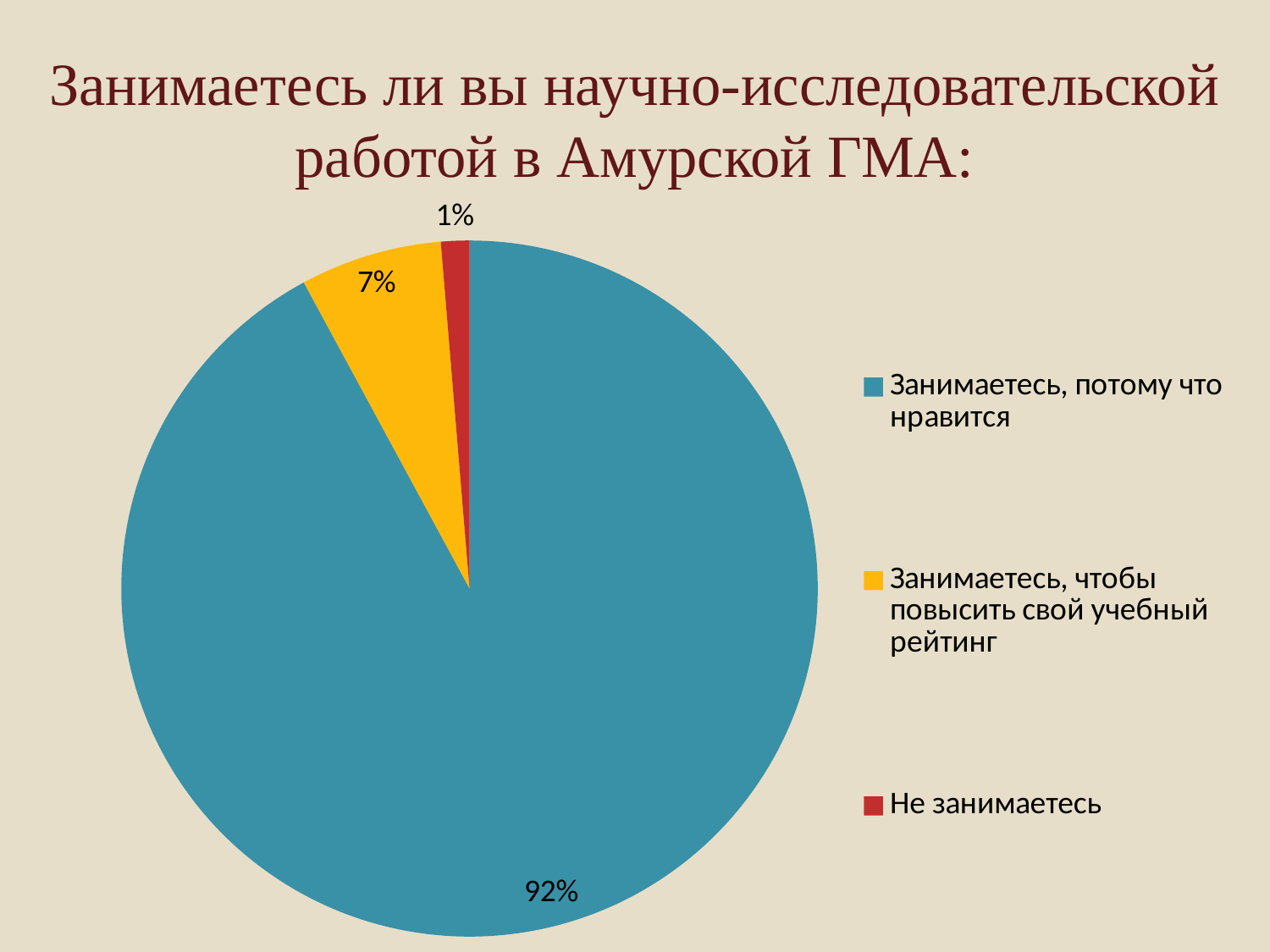
How many slices does the pie chart have? 3 Which category has the largest slice of the pie? Занимаетесь, потому что нравится What is the difference in percentage points between the "Занимаетесь, потому что нравится" slice and the "Занимаетесь, чтобы повысить свой учебный рейтинг" slice? 85 Which is larger: the "Занимаетесь, чтобы повысить свой учебный рейтинг" slice or the "Не занимаетесь" slice? Занимаетесь, чтобы повысить свой учебный рейтинг What kind of chart is shown on the slide? pie chart What colour is the slice for "Не занимаетесь"? red How many entries does the legend list? 3 What is the title of the slide? Занимаетесь ли вы научно-исследовательской работой в Амурской ГМА: Which category has the smallest slice of the pie? Не занимаетесь What share of the pie is labelled "Занимаетесь, потому что нравится"? 92% What share of the pie is labelled "Не занимаетесь"? 1% What share of the pie is labelled "Занимаетесь, чтобы повысить свой учебный рейтинг"? 7%